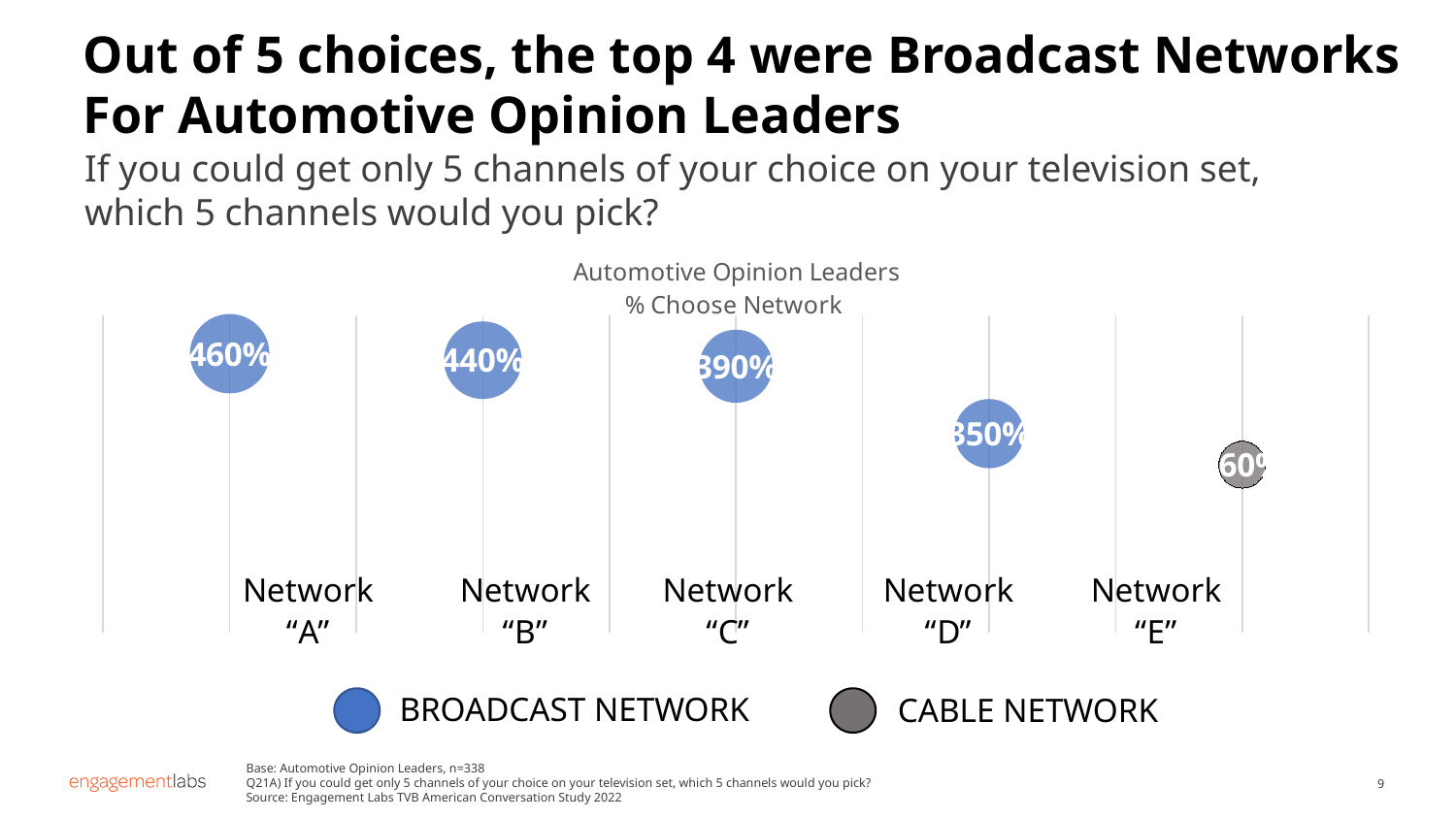
Which network has the highest value? Network "A" What is the difference between the values for Network "A" and Network "B"? 20% Which network has the lowest value? Network "E" How many networks are plotted on the chart? 5 What is the value shown for Network "C"? 390% Which network is shown as a Cable Network in the chart? Network "E" How many series does the legend list? 2 What is the value shown for Network "B"? 440% What is the value shown for Network "D"? 350% Which has a larger value, Network "A" or Network "B"? Network "A" Do the values rise or fall from Network "A" to Network "E"? fall What is the value shown for Network "A"? 460%